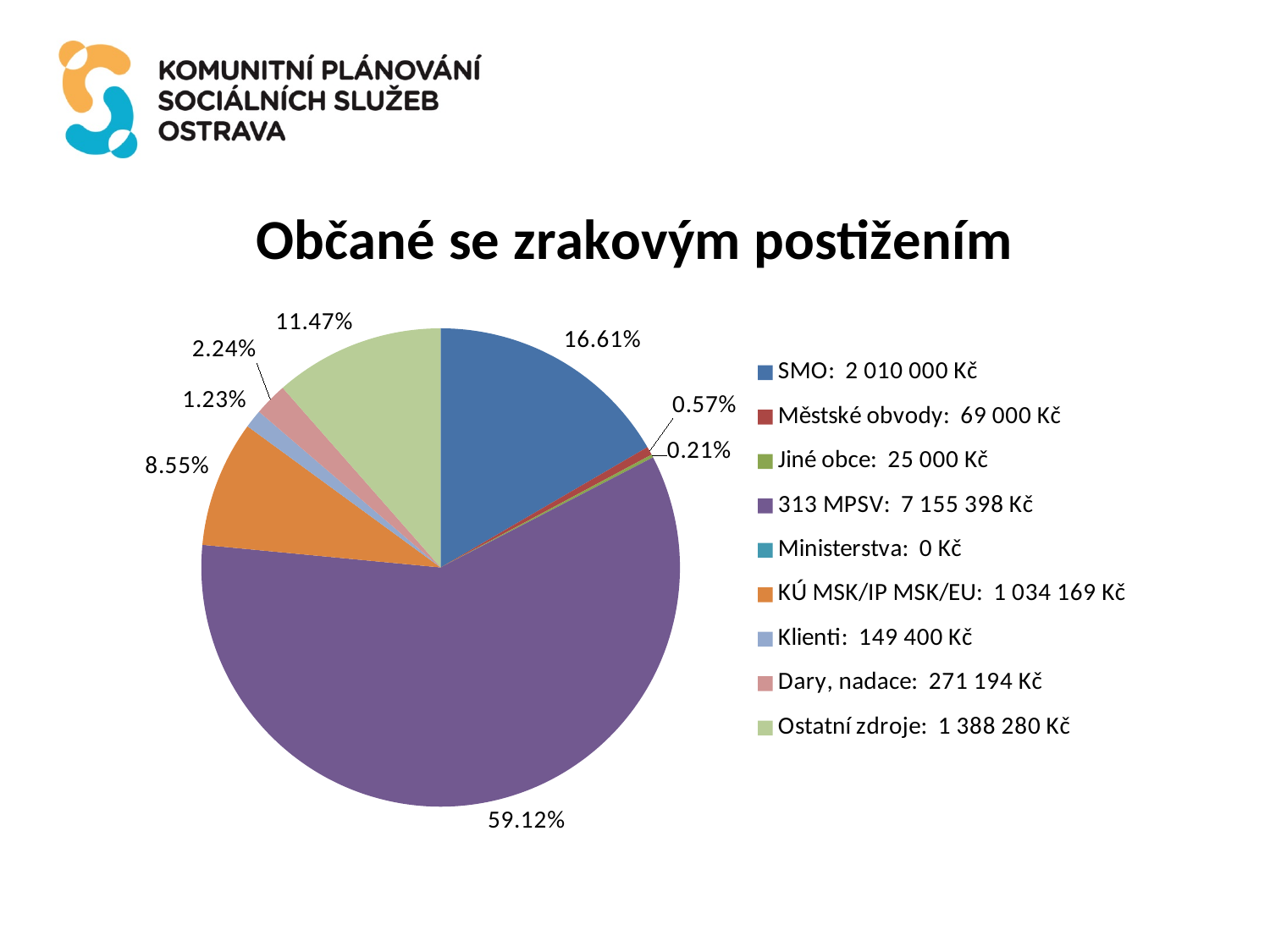
What type of chart is shown on the slide? pie chart Which source has the largest share of the pie? 313 MPSV What amount is shown for SMO in the legend? 2 010 000 Kč How many entries does the chart legend list? 9 What is the difference in percentage points between the 313 MPSV share and the SMO share? 42.51 Which is larger, the share for KÚ MSK/IP MSK/EU or the share for Ostatní zdroje? Ostatní zdroje What percentage share does the 313 MPSV slice have? 59.12% What amount is shown for 313 MPSV in the legend? 7 155 398 Kč What percentage share does the SMO slice have? 16.61% What is the title of the chart? Občané se zrakovým postižením What amount is shown for Dary, nadace in the legend? 271 194 Kč Which legend entry has a value of 0 Kč? Ministerstva